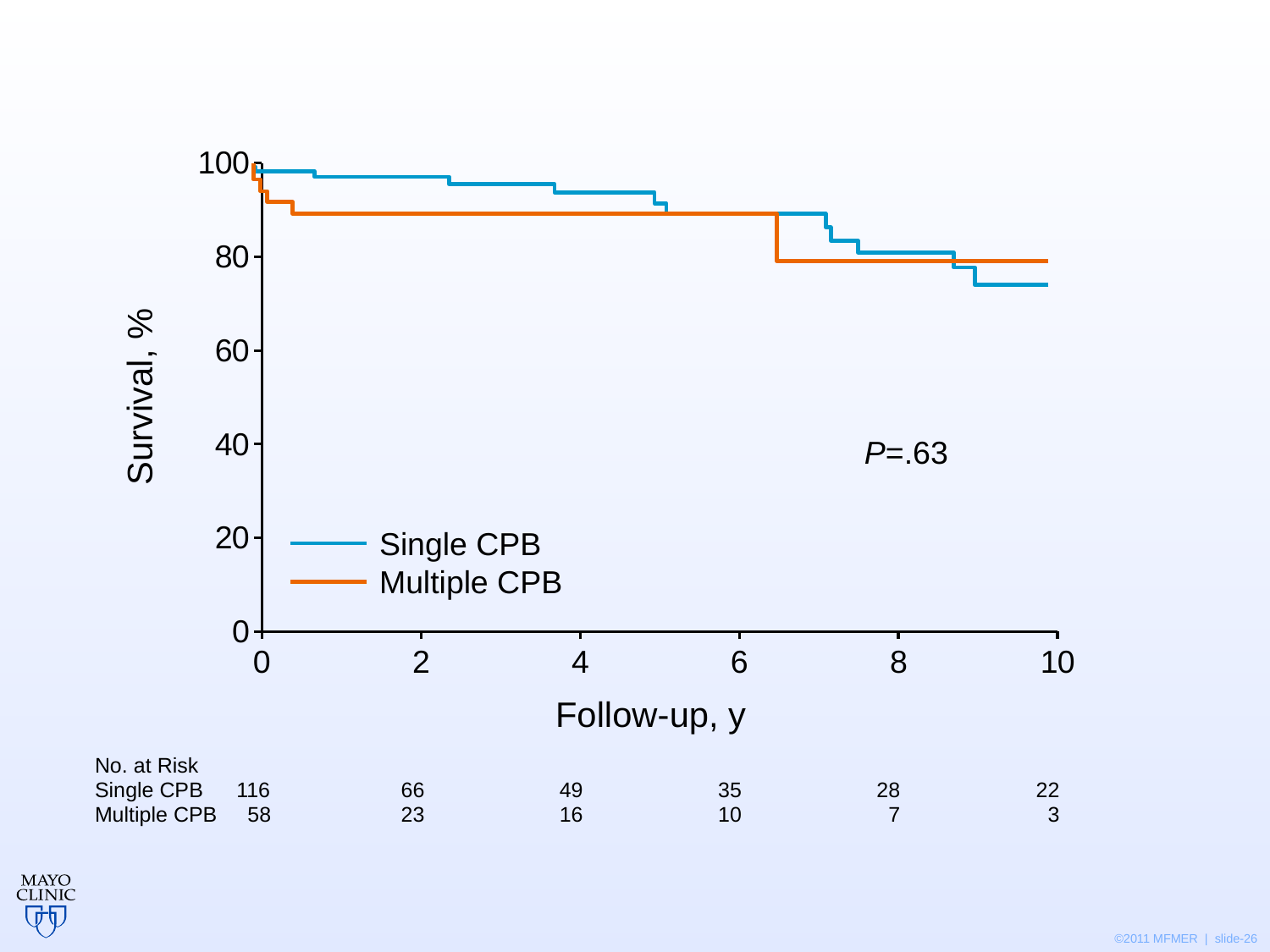
According to the No. at Risk table, how many Single CPB patients were at risk at 10 years? 22 What P value is printed on the chart? P=.63 How many series does the legend list? 2 According to the No. at Risk table, how many Multiple CPB patients were at risk at 8 years? 7 According to the No. at Risk table, how many Multiple CPB patients were at risk at 0 years? 58 According to the No. at Risk table, how many Single CPB patients were at risk at 0 years? 116 What is the difference between the number of Single CPB and Multiple CPB patients at risk at 0 years? 58 What are the two series named in the legend? Single CPB and Multiple CPB What kind of chart is shown on the slide? line chart Is the survival for Single CPB at 4 years of follow-up greater or less than 80? greater At 2 years of follow-up, which curve shows higher survival, Single CPB or Multiple CPB? Single CPB Do the survival curves rise or fall as follow-up time increases? fall